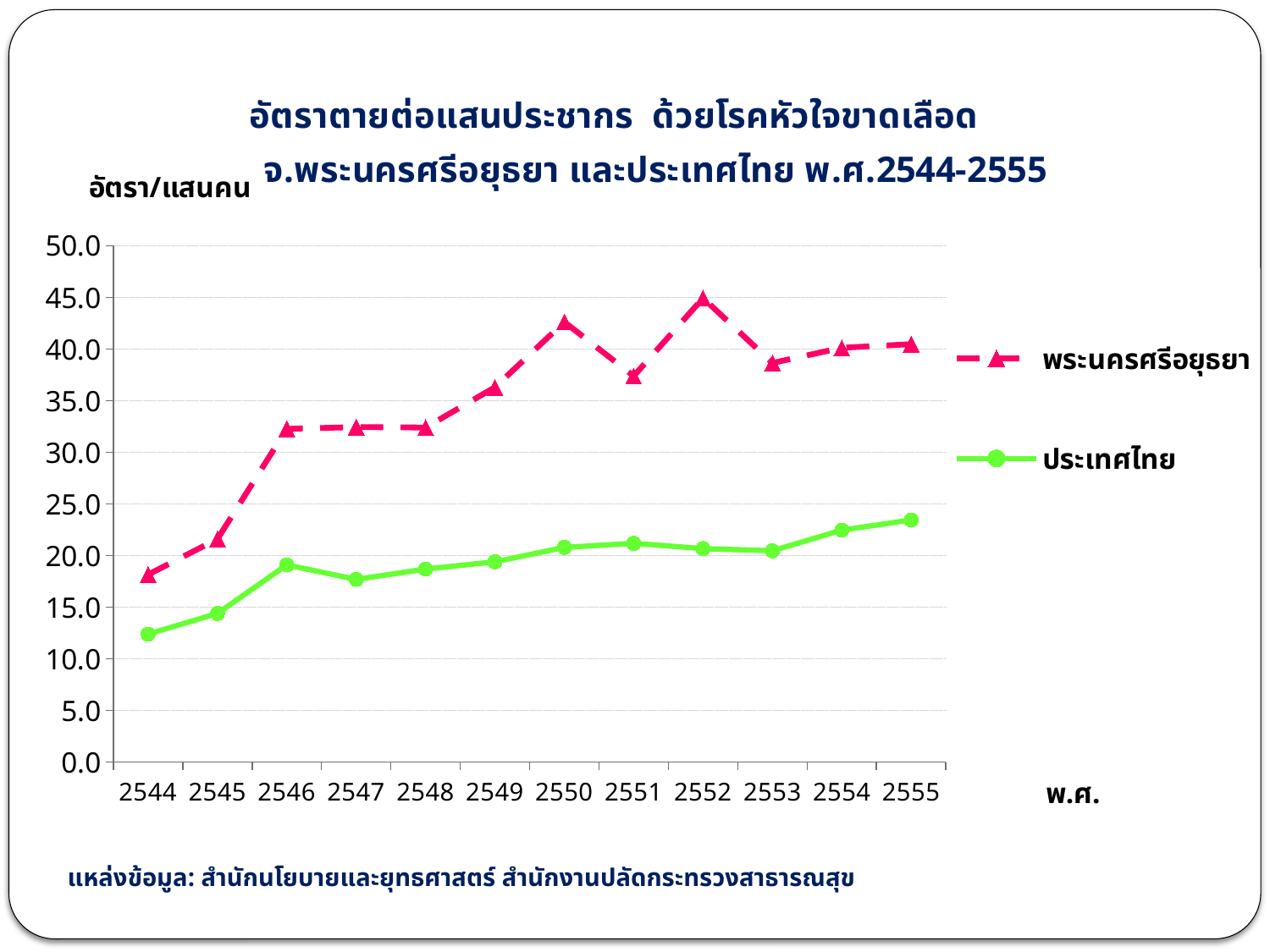
How many years are plotted along the x axis? 12 Overall, do the values for ประเทศไทย rise or fall from 2544 to 2555? rise Is the value for ประเทศไทย in 2544 greater or less than 15.0? less In which year does the ประเทศไทย series reach its highest value? 2555 Which series has the higher value in 2550, พระนครศรีอยุธยา or ประเทศไทย? พระนครศรีอยุธยา In which year does the ประเทศไทย series have its lowest value? 2544 Is the value for พระนครศรีอยุธยา in 2544 greater or less than 20.0? less Is the value for พระนครศรีอยุธยา in 2552 greater or less than 40.0? greater What kind of chart is shown on the slide? line chart In which year does the พระนครศรีอยุธยา series have its lowest value? 2544 In which year does the พระนครศรีอยุธยา series reach its highest value? 2552 How many series does the legend list? 2